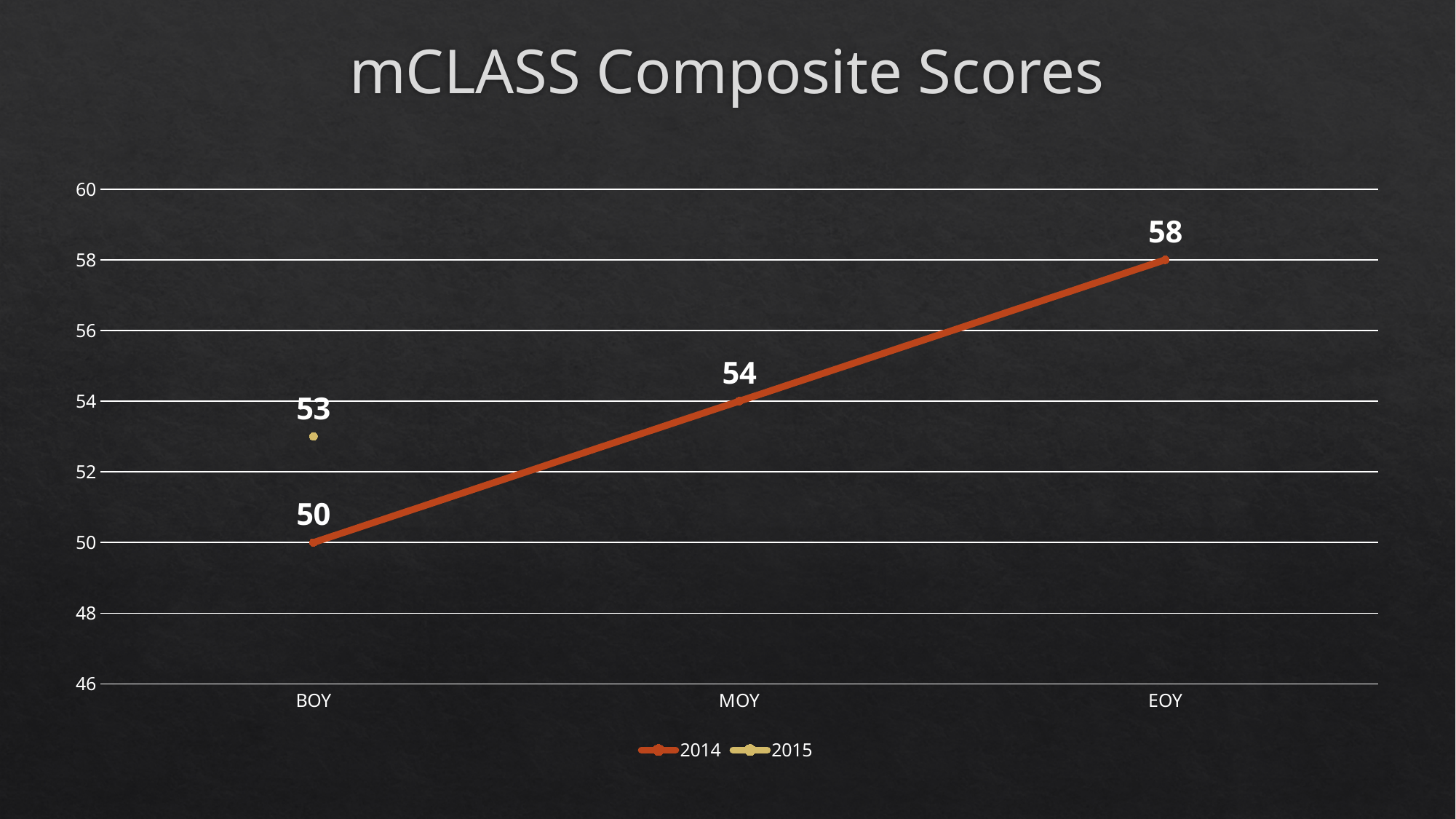
At which point is the 2014 series lowest? BOY How many series does the legend list? 2 What is the difference between the 2014 EOY value and the 2014 BOY value? 8 What is the 2014 value at MOY? 54 At which point is the 2014 series highest? EOY What is the 2014 value at BOY? 50 What kind of chart is this? line chart What is the 2014 value at EOY? 58 At BOY, which series has the larger value, 2014 or 2015? 2015 Does the 2014 series rise or fall from BOY to EOY? rise What is the 2015 value at BOY? 53 How many categories are on the x axis? 3